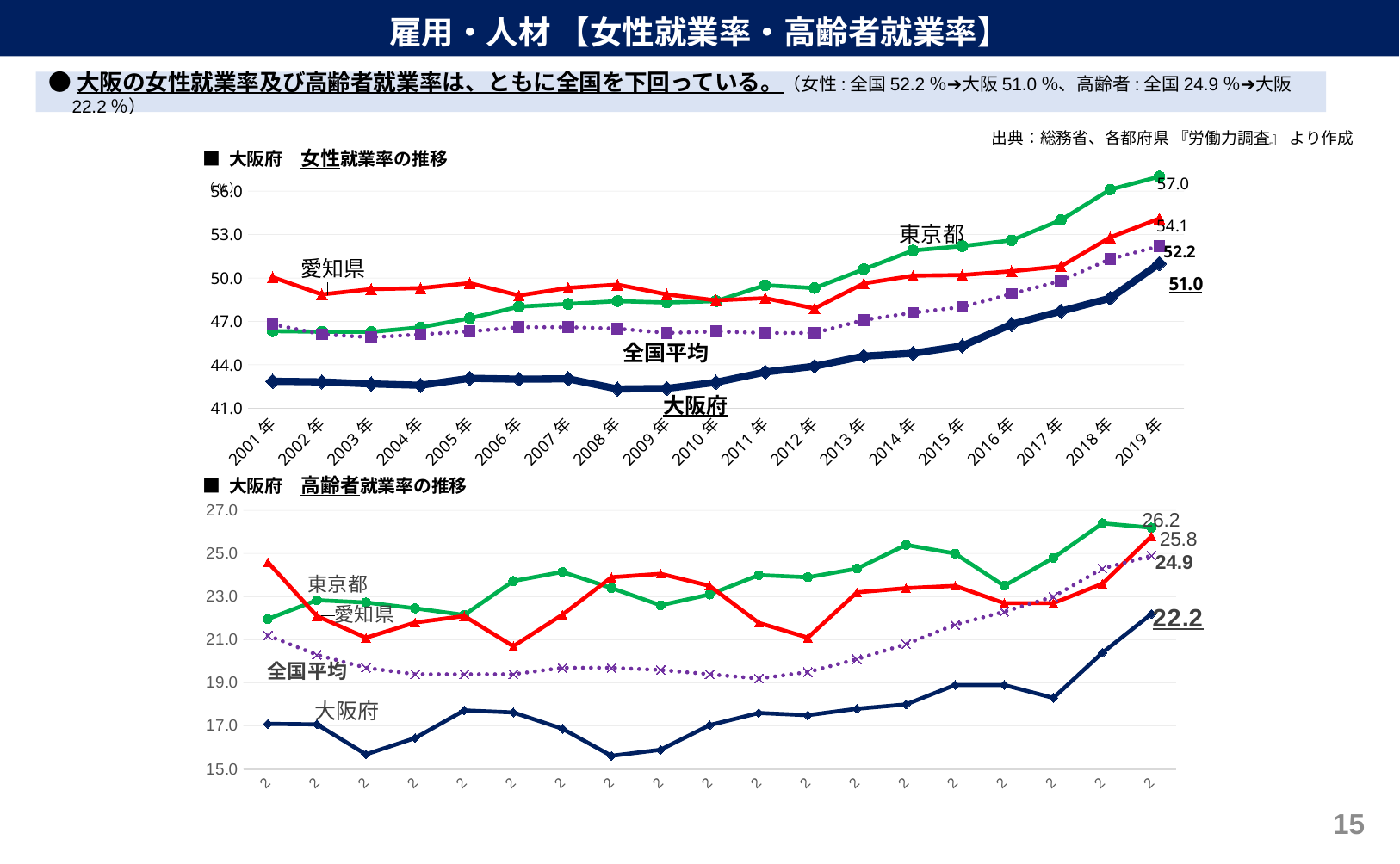
In the top chart (大阪府 女性就業率の推移), does the 大阪府 line generally rise or fall from 2010 to 2019? rise In the top chart (大阪府 女性就業率の推移), what is the difference between the 2019 values for 東京都 and 大阪府? 6.0 In the top chart (大阪府 女性就業率の推移), how many years are shown on the x axis? 19 In the top chart (大阪府 女性就業率の推移), what is the 2019 value for 東京都? 57.0 In the top chart (大阪府 女性就業率の推移), which series has the highest value in 2019? 東京都 In the bottom chart (大阪府 高齢者就業率の推移), what is the final value for 大阪府? 22.2 In the top chart (大阪府 女性就業率の推移), what is the 2019 value for 全国平均? 52.2 In the top chart (大阪府 女性就業率の推移), is the 2001 value for 大阪府 greater or less than 44.0? less What type of chart is the bottom chart (大阪府 高齢者就業率の推移)? line chart In the bottom chart (大阪府 高齢者就業率の推移), what is the final value for 愛知県? 25.8 In the bottom chart (大阪府 高齢者就業率の推移), which series has the lowest final value? 大阪府 In the top chart (大阪府 女性就業率の推移), what is the 2019 value for 大阪府? 51.0